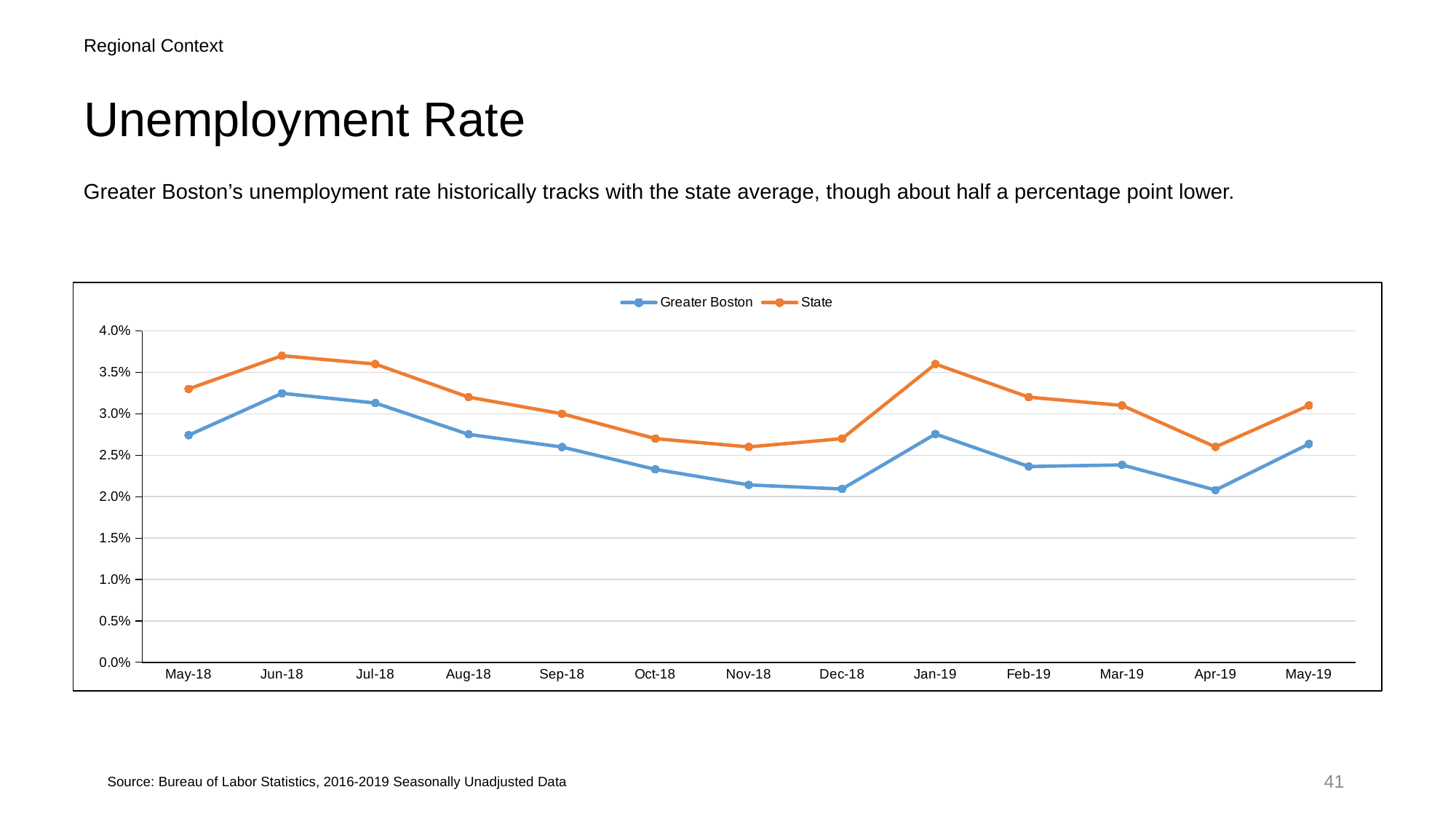
In which month does the State series reach its highest value? Jun-18 Which series has the higher value in Jan-19, Greater Boston or State? State What kind of chart is shown on the slide? line chart Is the State value for Oct-18 greater or less than 3.0%? less Is the Greater Boston value for Apr-19 greater or less than 2.5%? less Is the State value for Jun-18 greater or less than 3.5%? greater Does the Greater Boston series rise or fall from Jun-18 to Dec-18? fall How many series does the legend list? 2 Which series is shown in orange? State How many months are plotted along the x axis? 13 In which month does the Greater Boston series reach its highest value? Jun-18